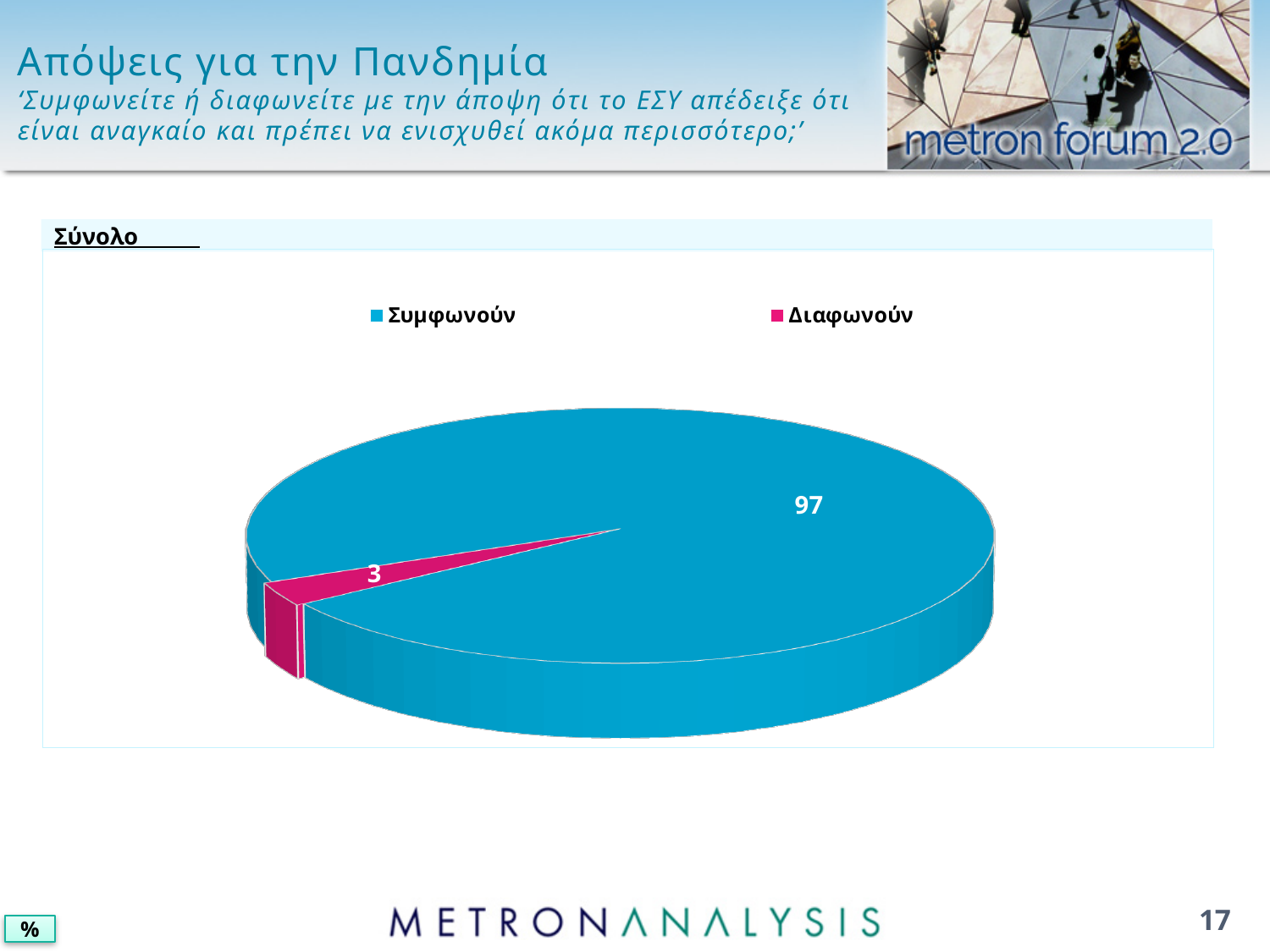
What colour is the Συμφωνούν slice in the pie chart? Blue How many slices does the pie chart have? 2 How many entries does the legend list? 2 Which is larger, the value for Συμφωνούν or the value for Διαφωνούν? Συμφωνούν Which category has the smallest slice in the pie chart? Διαφωνούν What kind of chart is shown on the slide? Pie chart Which category has the largest slice in the pie chart? Συμφωνούν What value is shown for Διαφωνούν in the pie chart? 3 What is the label above the chart box? Σύνολο What share of the pie does the Διαφωνούν slice represent? 3% What is the difference between the values for Συμφωνούν and Διαφωνούν? 94 What value is shown for Συμφωνούν in the pie chart? 97